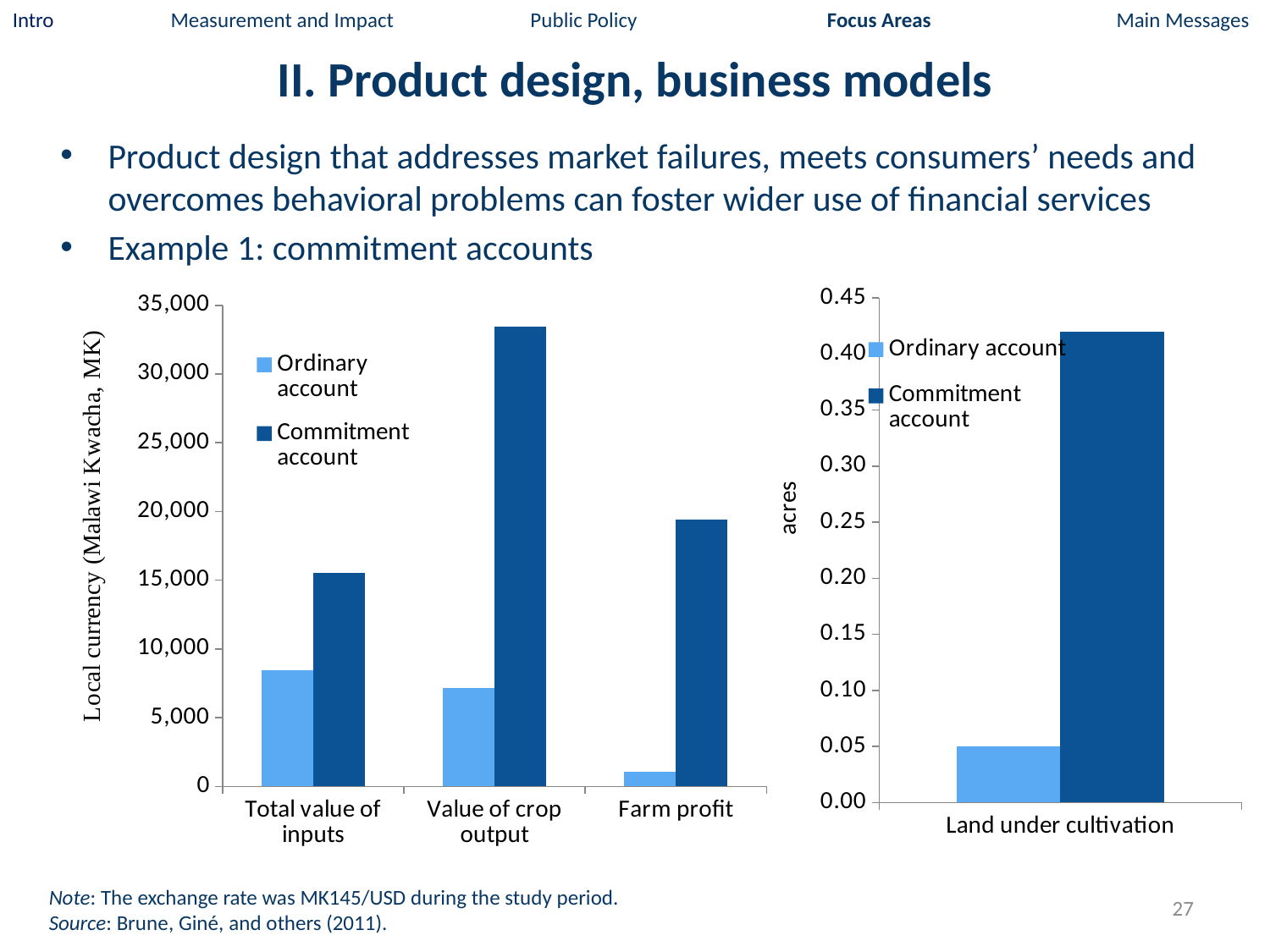
What is the y-axis label of the left chart? Local currency (Malawi Kwacha, MK) In the left chart, which is larger for Farm profit: the Ordinary account or the Commitment account? Commitment account How many series does the legend of the left chart list? 2 In the left chart, is the Commitment account value for Farm profit greater or less than 15,000? greater In the right chart (Land under cultivation), is the Commitment account value greater or less than 0.40? greater What kind of chart is the left chart (Local currency, Malawi Kwacha)? bar chart How many categories are shown on the x axis of the left chart? 3 In the left chart, is the Ordinary account value for Total value of inputs greater or less than 10,000? less In the left chart, which category has the lowest Ordinary account value? Farm profit In the left chart, which category has the highest Commitment account value? Value of crop output In the right chart (Land under cultivation), which is larger: the Ordinary account or the Commitment account? Commitment account